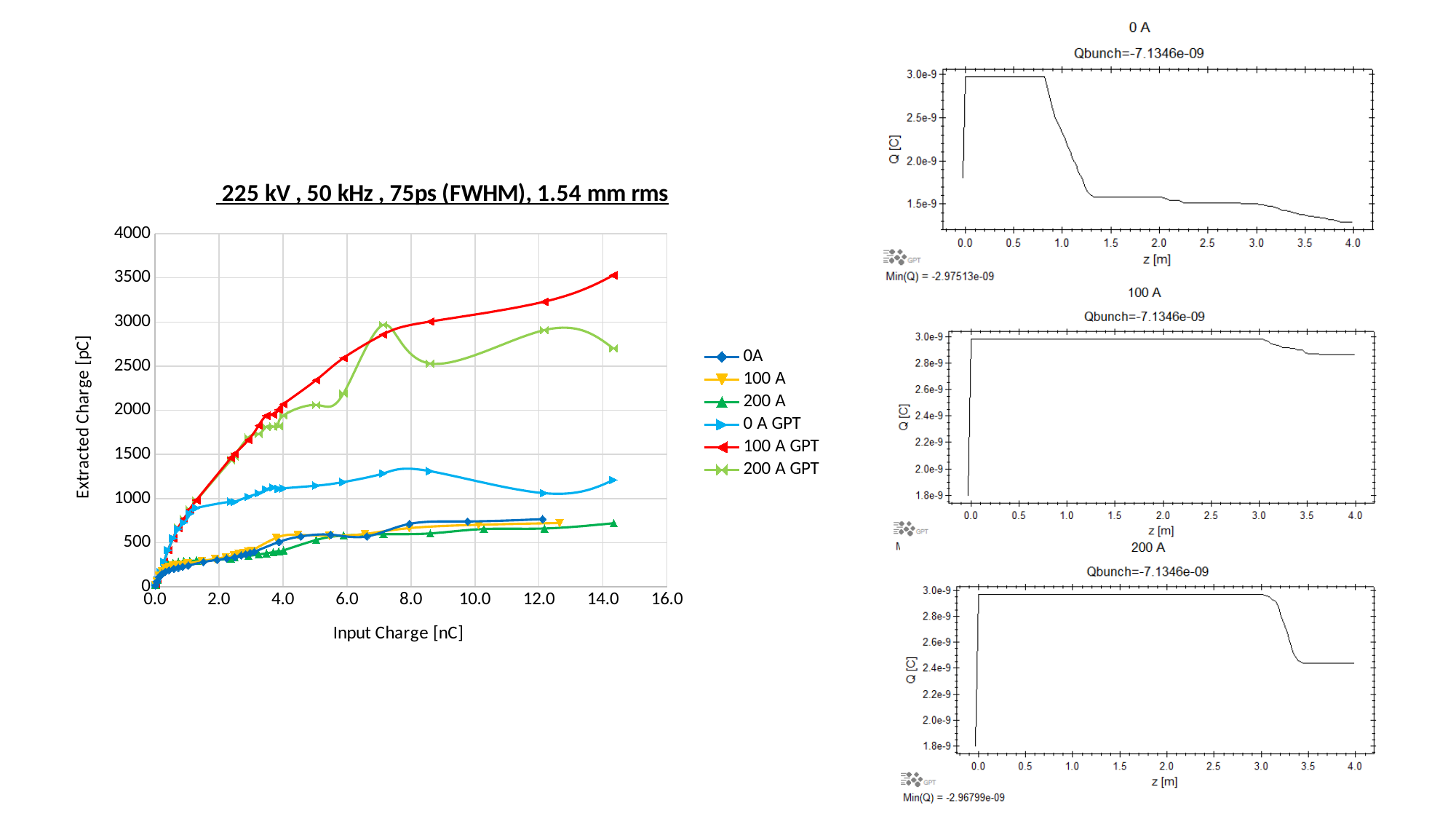
In the left chart, is the value of the 100 A GPT series at its last point (around 14.3 nC input charge) greater or less than 3000? greater In the left chart, at about 12.0 nC input charge, which series has the larger value: 0 A GPT or 0A? 0 A GPT In the top-right chart titled 0 A, what is the Qbunch value printed in the subtitle? Qbunch=-7.1346e-09 In the left chart, is the value of the 200 A series at about 14.3 nC input charge greater or less than 1000? less In the left chart, is the value of the 0 A GPT series at about 8.0 nC input charge greater or less than 1500? less What Min(Q) value is printed below the bottom-right chart titled 200 A? Min(Q) = -2.96799e-09 How many series does the legend of the left chart list? 6 What is the title of the left chart? 225 kV , 50 kHz , 75ps (FWHM), 1.54 mm rms In the left chart, which series reaches the highest extracted charge? 100 A GPT In the left chart, does the 100 A GPT series rise or fall as input charge increases? rise What kind of chart is the large chart on the left of the slide? line chart